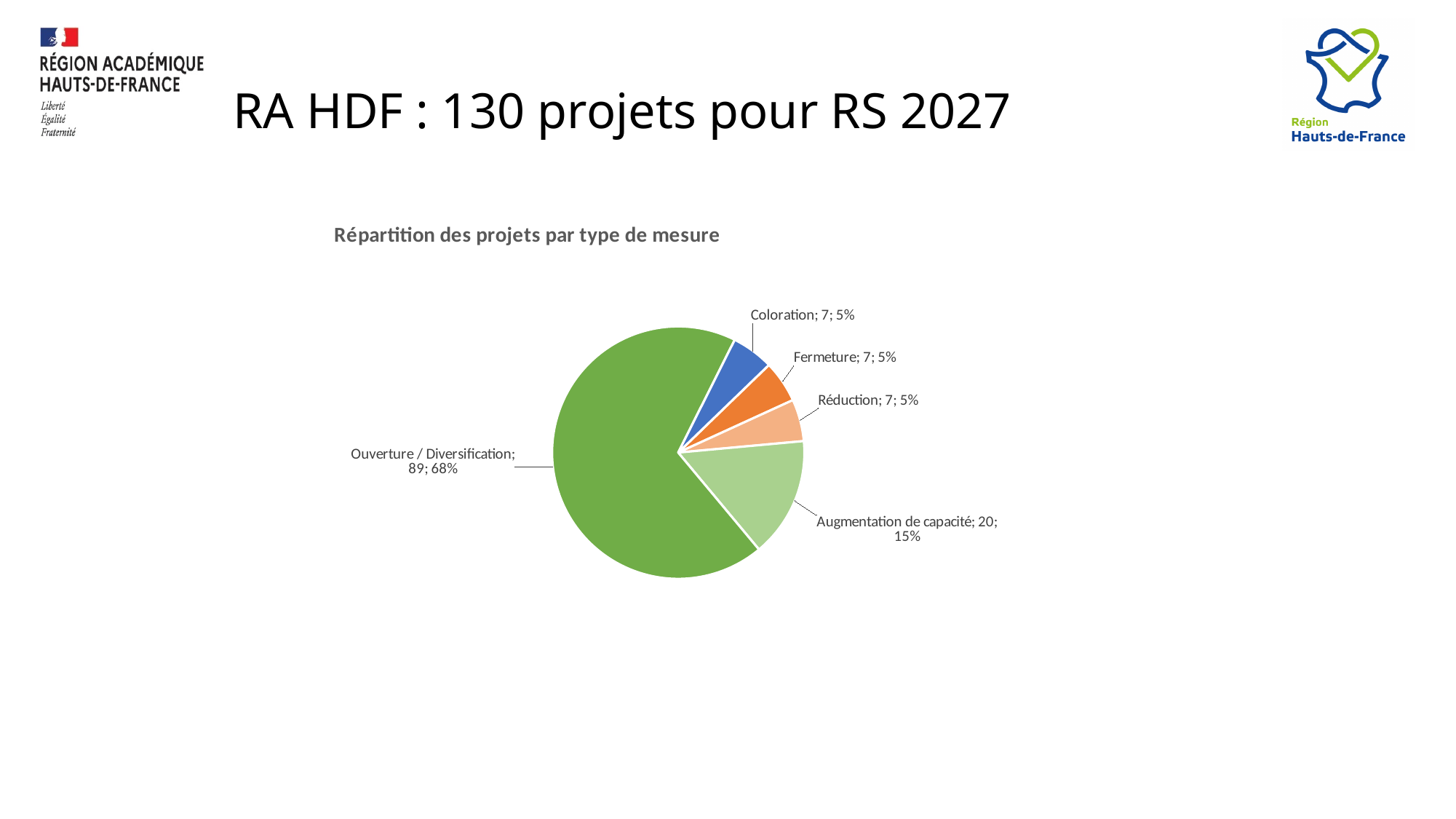
What share of the pie does Augmentation de capacité represent? 15% How many projects are in the Coloration category? 7 What share of the pie does Réduction represent? 5% Which category has the largest slice? Ouverture / Diversification What is the title of the chart? Répartition des projets par type de mesure What is the difference in number of projects between Ouverture / Diversification and Augmentation de capacité? 69 What type of chart is shown on the slide? pie chart How many projects are in the Ouverture / Diversification category? 89 How many slices does the pie chart have? 5 What share of the pie does Ouverture / Diversification represent? 68% What is the total number of projects across all slices of the pie? 130 Which is larger, the number of projects for Augmentation de capacité or for Fermeture? Augmentation de capacité